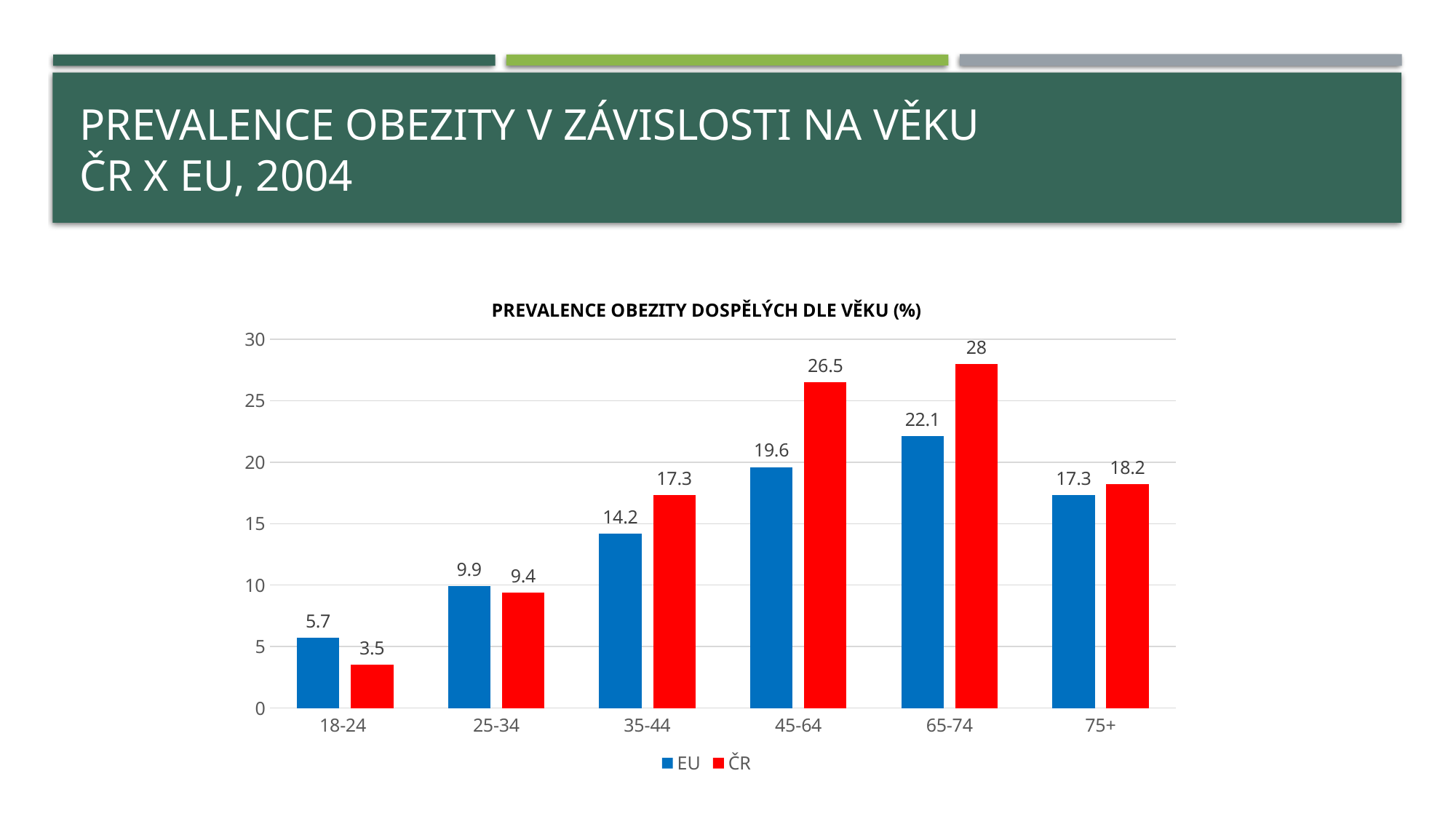
What is the ČR value for the 75+ age group? 18.2 Which age group has the highest ČR value? 65-74 What is the title of the chart? PREVALENCE OBEZITY DOSPĚLÝCH DLE VĚKU (%) Is the ČR value for the 65-74 age group greater or less than 25? greater What kind of chart is shown on the slide? bar chart What is the difference between the ČR and EU values for the 45-64 age group? 6.9 What is the ČR value for the 18-24 age group? 3.5 How many age groups are shown on the x axis? 6 How many series does the legend list? 2 Which age group has the lowest EU value? 18-24 What is the EU value for the 45-64 age group? 19.6 Which is larger for the 25-34 age group, the EU value or the ČR value? EU